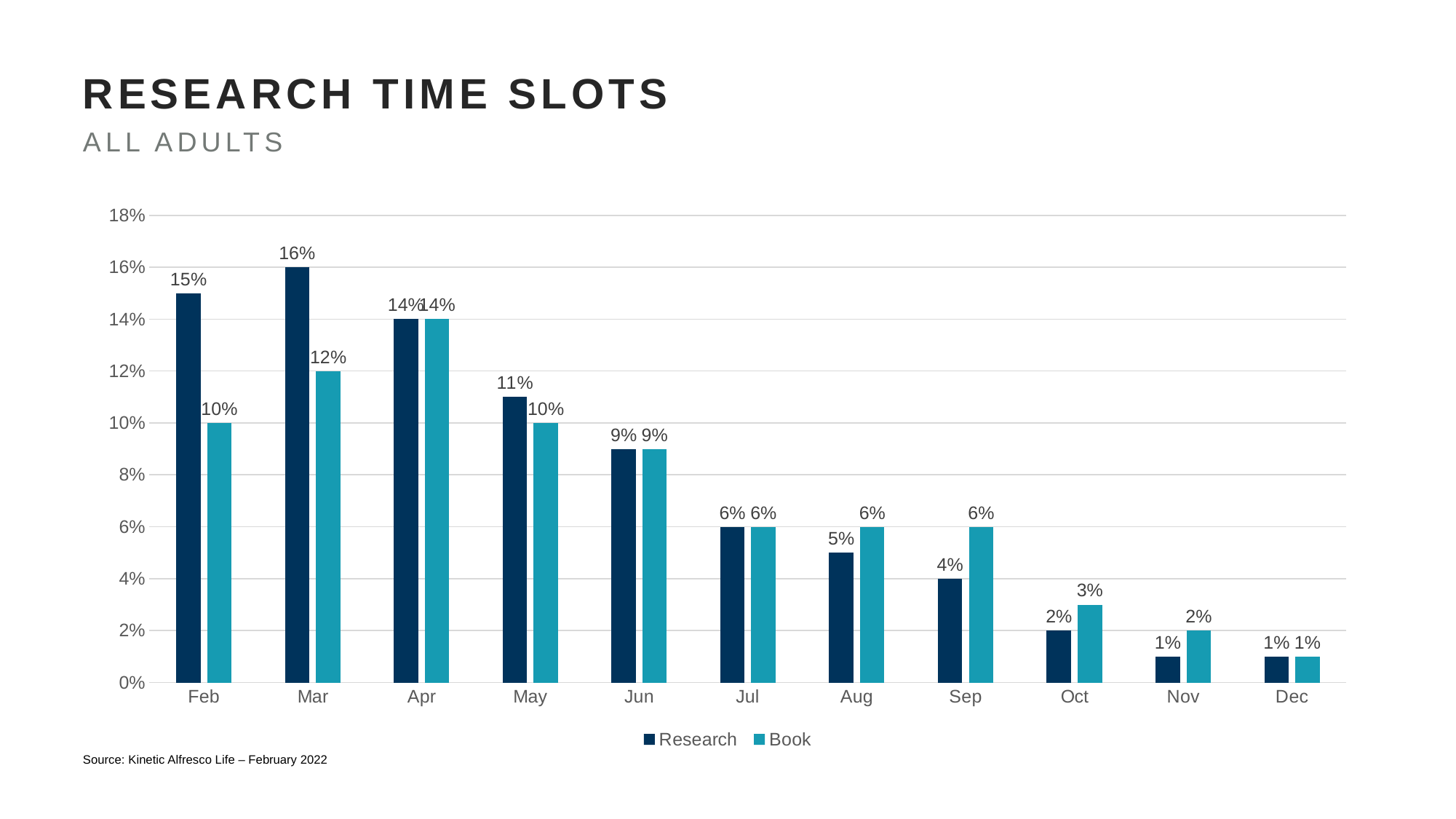
What kind of chart is shown on the slide? Bar chart Which is larger for Sep, the Research value or the Book value? Book What is the Research value for Mar? 16% What is the Book value for Oct? 3% How many months are shown on the x axis? 11 What is the Book value for Feb? 10% Do the Research values generally rise or fall from Mar to Dec? Fall Which month has the highest Research value? Mar How many series does the legend list? 2 Which month has the highest Book value? Apr What is the difference between the Research values for Mar and May? 5% What is the difference between the Research and Book values for Feb? 5%